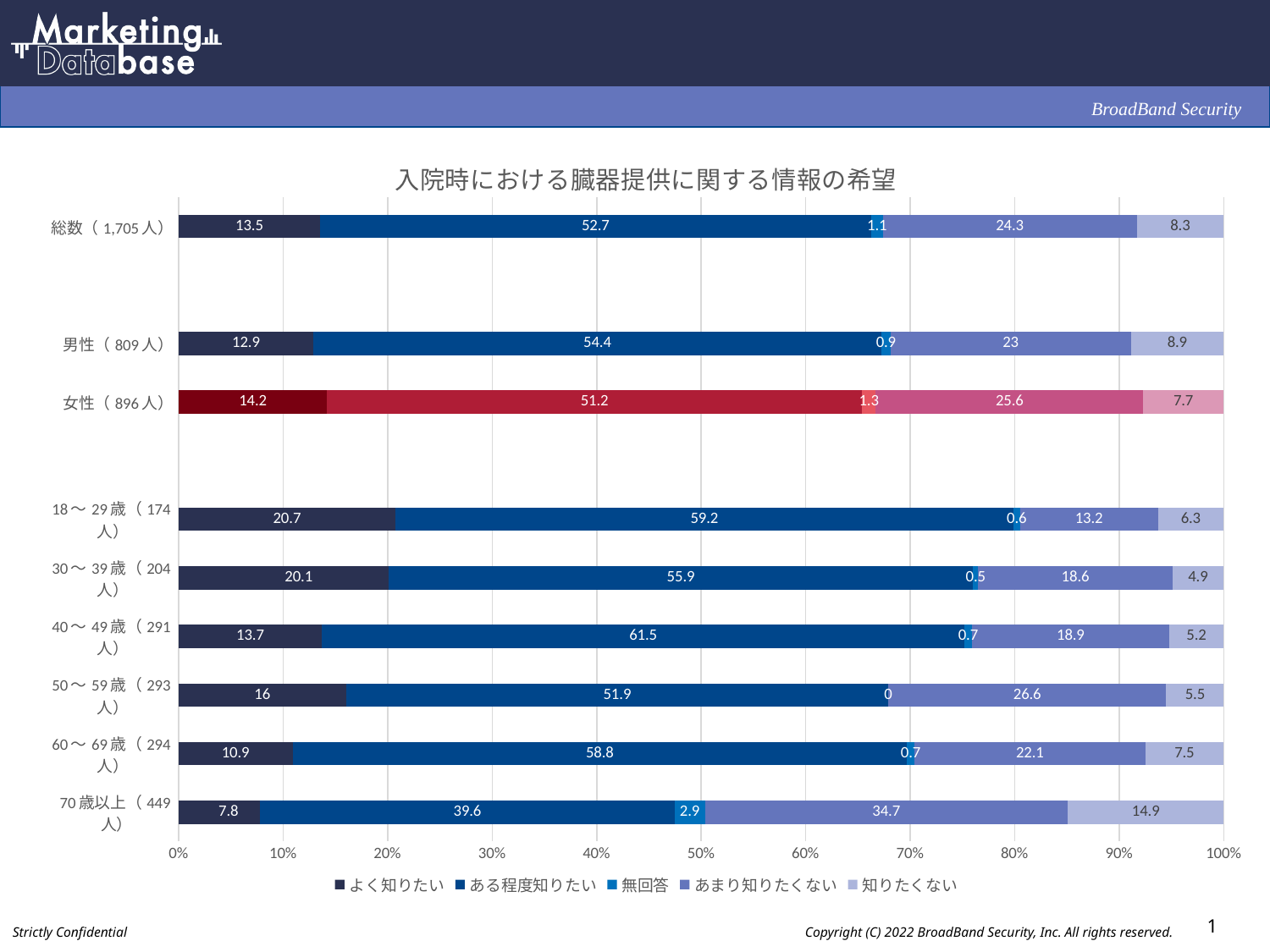
What is the value of ある程度知りたい for 40〜49歳 (291人)? 61.5 How many categories are shown on the chart? 9 What is the value of よく知りたい for 総数 (1,705人)? 13.5 What is the difference between the ある程度知りたい values for 男性 (809人) and 女性 (896人)? 3.2 How many series does the legend list? 5 Which category has the highest value for よく知りたい? 18〜29歳 (174人) Which category has the lowest value for ある程度知りたい? 70歳以上 (449人) What is the value of あまり知りたくない for 女性 (896人)? 25.6 Which is larger, the 知りたくない value for 男性 (809人) or for 女性 (896人)? 男性 (809人) What kind of chart is shown on the slide? Stacked bar chart What is the title of the chart? 入院時における臓器提供に関する情報の希望 What is the value of 知りたくない for 70歳以上 (449人)? 14.9